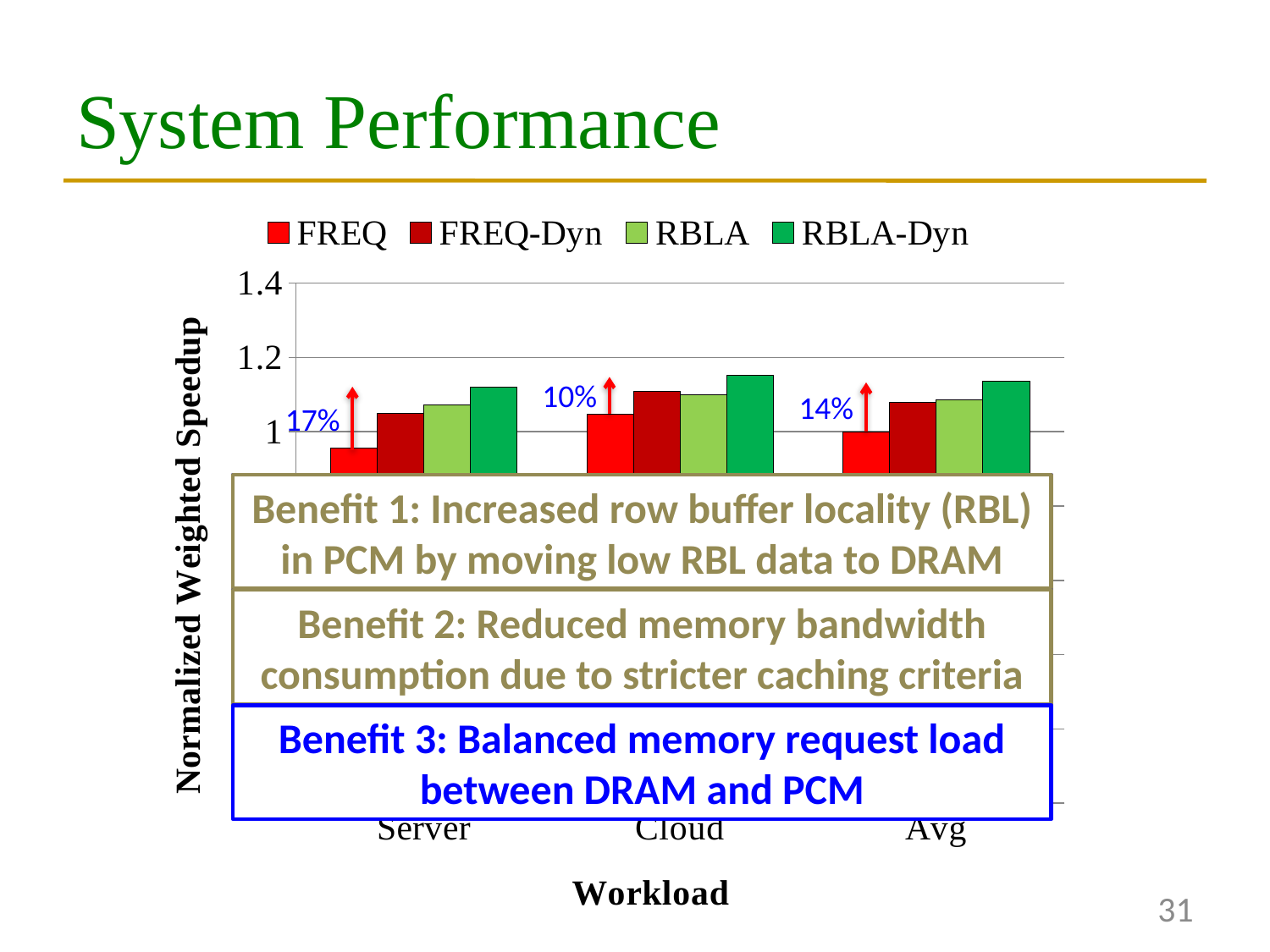
What percentage improvement is annotated above the Server group? 17% Is the RBLA-Dyn value for Cloud greater or less than 1.2? less Which series has the highest bar for the Cloud workload? RBLA-Dyn How many series does the legend list? 4 Is the FREQ value for Server greater or less than 1? less How many workload categories are shown on the x axis? 3 Which series has the highest bar for the Server workload? RBLA-Dyn Which series has the lowest bar for the Server workload? FREQ Which series has the lowest bar for the Avg workload? FREQ What is the title of the y axis? Normalized Weighted Speedup What kind of chart is shown on the slide? bar chart For the Avg workload, which is larger: the FREQ bar or the RBLA-Dyn bar? RBLA-Dyn